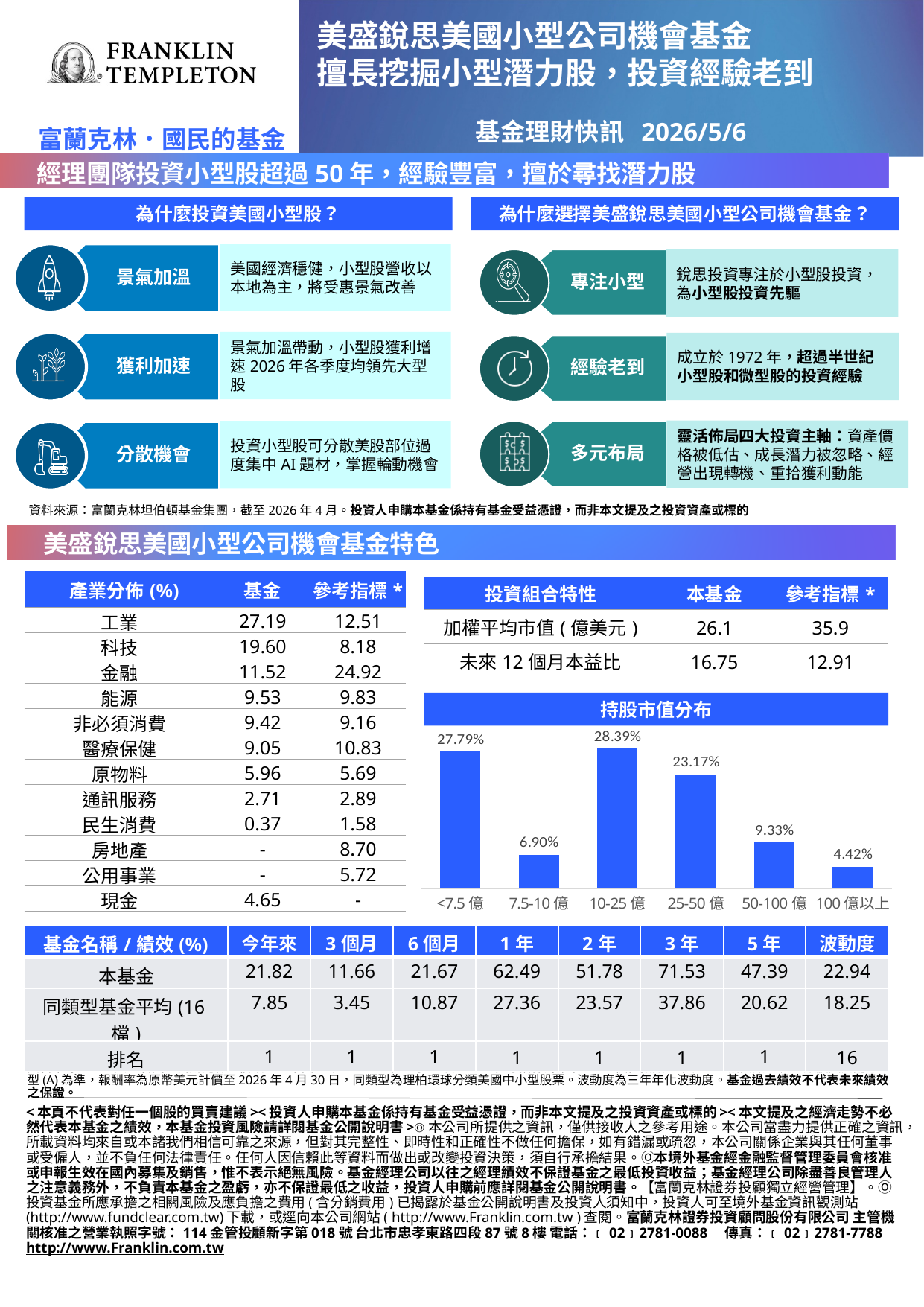
In the 持股市值分布 chart, what is the value for 50-100 億? 9.33% In the 持股市值分布 chart, what is the value for <7.5 億? 27.79% In the 持股市值分布 chart, which category has the highest value? 10-25 億 What is the title of the bar chart on the slide? 持股市值分布 In the 持股市值分布 chart, which is larger: the value for 7.5-10 億 or the value for 50-100 億? 50-100 億 In the 持股市值分布 chart, which category has the lowest value? 100 億以上 In the 持股市值分布 chart, what is the value for 25-50 億? 23.17% In the 持股市值分布 chart, what is the value for 7.5-10 億? 6.90% How many categories are shown in the 持股市值分布 chart? 6 In the 持股市值分布 chart, what is the difference between the values for 10-25 億 and 25-50 億? 5.22% In the 持股市值分布 chart, what is the difference between the values for <7.5 億 and 100 億以上? 23.37% What type of chart is the 持股市值分布 chart? bar chart